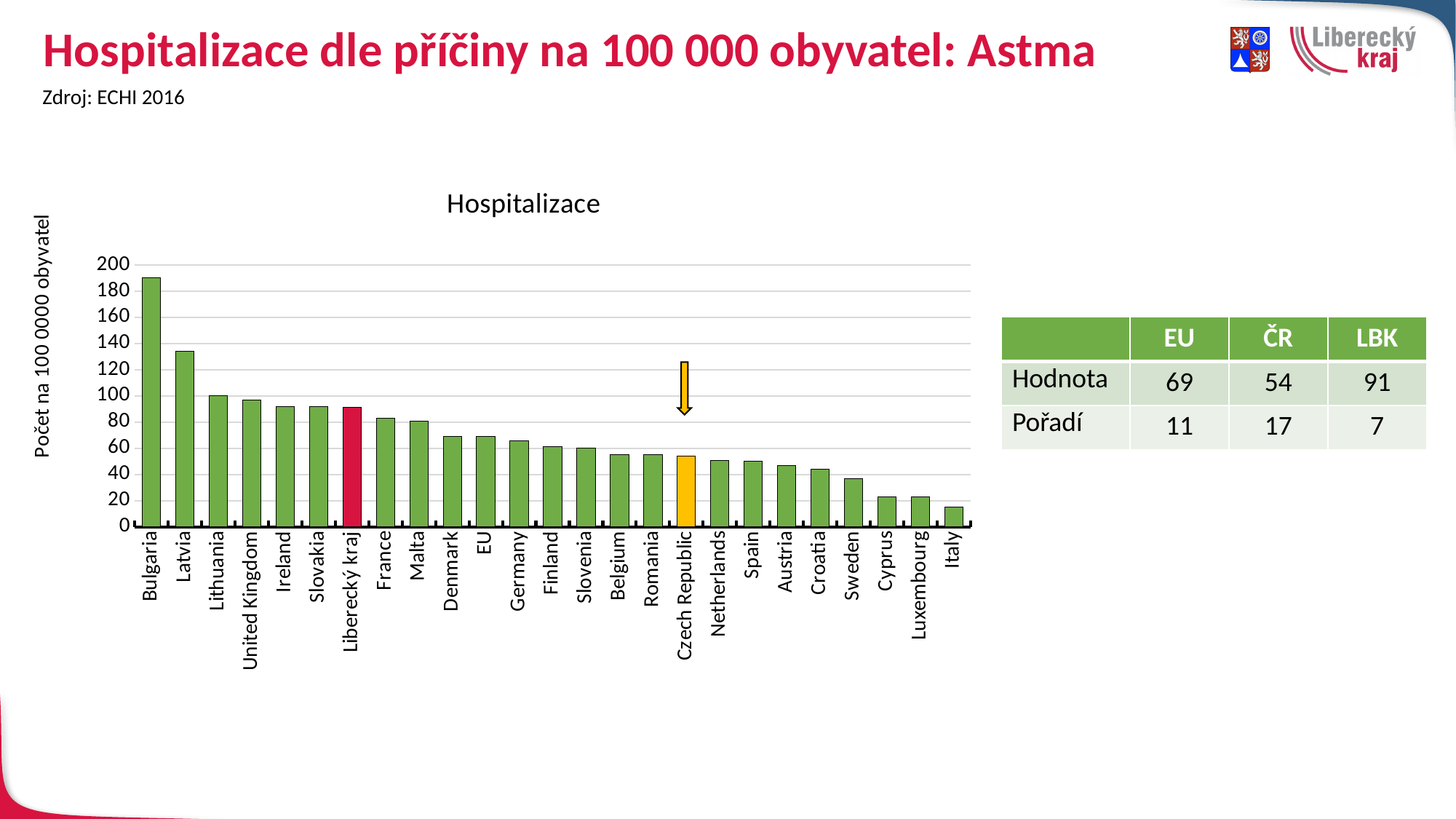
Is the value for Bulgaria greater or less than 180? greater Do the values rise or fall from left to right along the x axis? fall What is the value for Czech Republic? 54 What is the value for EU? 69 Which category has the lowest value in the chart? Italy Which category has the highest value in the chart? Bulgaria How many categories are plotted on the x axis of the chart? 25 What is the title of the chart? Hospitalizace Which is larger, the value for Latvia or the value for Lithuania? Latvia What kind of chart is shown on the slide? bar chart What is the difference between the values for Liberecký kraj and EU? 22 What is the value for Liberecký kraj? 91